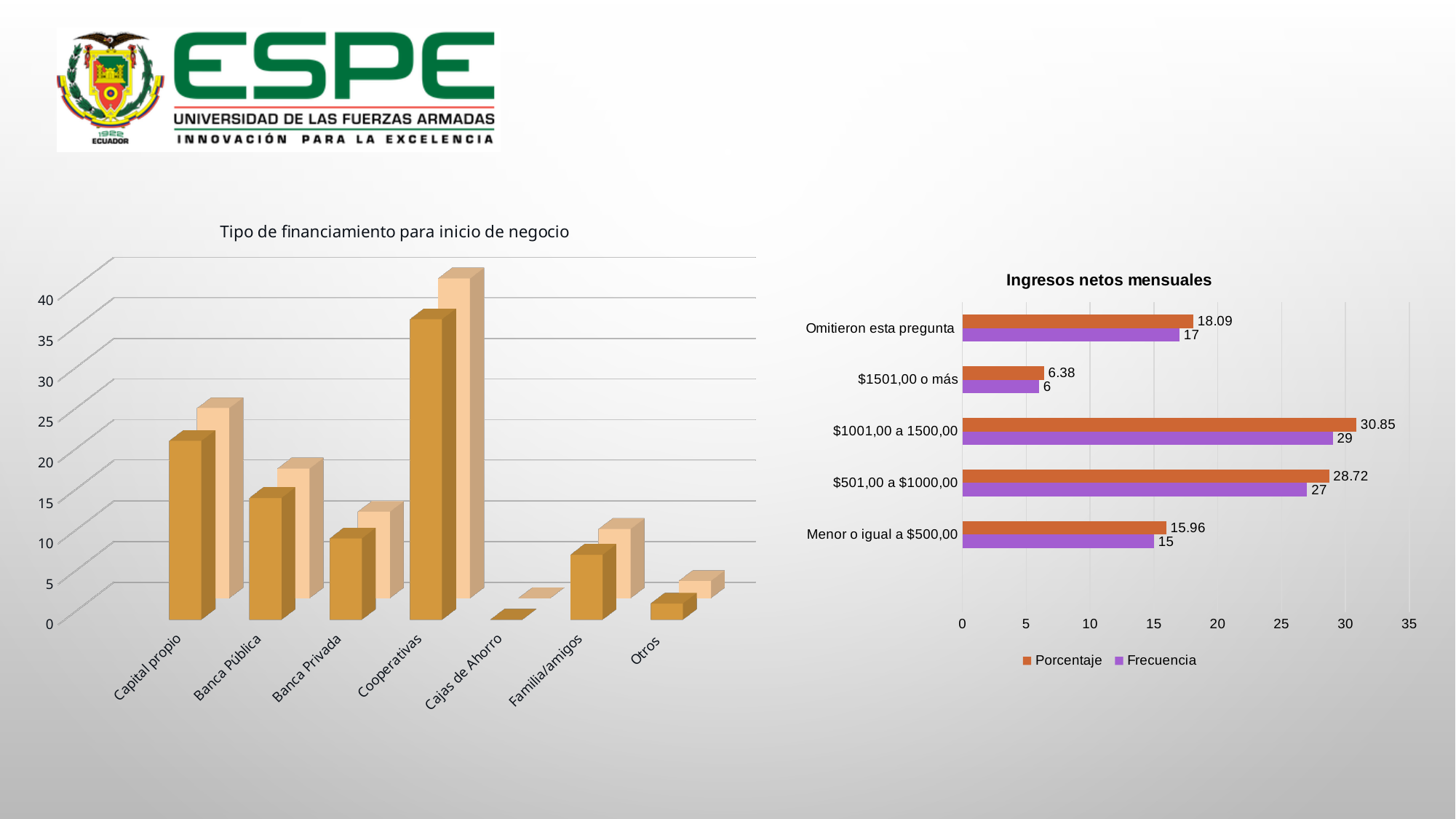
In the 'Tipo de financiamiento para inicio de negocio' chart, which category has the highest bars? Cooperativas In the 'Ingresos netos mensuales' chart, which category has the highest Porcentaje? $1001,00 a 1500,00 In the 'Ingresos netos mensuales' chart, what is the Porcentaje value for '$1001,00 a 1500,00'? 30.85 How many series does the legend of the 'Ingresos netos mensuales' chart list? 2 In the 'Ingresos netos mensuales' chart, what is the Frecuencia value for 'Omitieron esta pregunta'? 17 In the 'Ingresos netos mensuales' chart, which category has the lowest Frecuencia? $1501,00 o más In the 'Ingresos netos mensuales' chart, which has a larger Porcentaje: 'Menor o igual a $500,00' or 'Omitieron esta pregunta'? Omitieron esta pregunta How many categories are shown in the 'Ingresos netos mensuales' chart? 5 How many categories are shown on the x axis of the 'Tipo de financiamiento para inicio de negocio' chart? 7 In the 'Tipo de financiamiento para inicio de negocio' chart, is the value of the dark bar for Cooperativas greater or less than 30? greater What kind of chart is 'Tipo de financiamiento para inicio de negocio'? Bar chart In the 'Ingresos netos mensuales' chart, what is the difference in Frecuencia between '$1001,00 a 1500,00' and '$501,00 a $1000,00'? 2